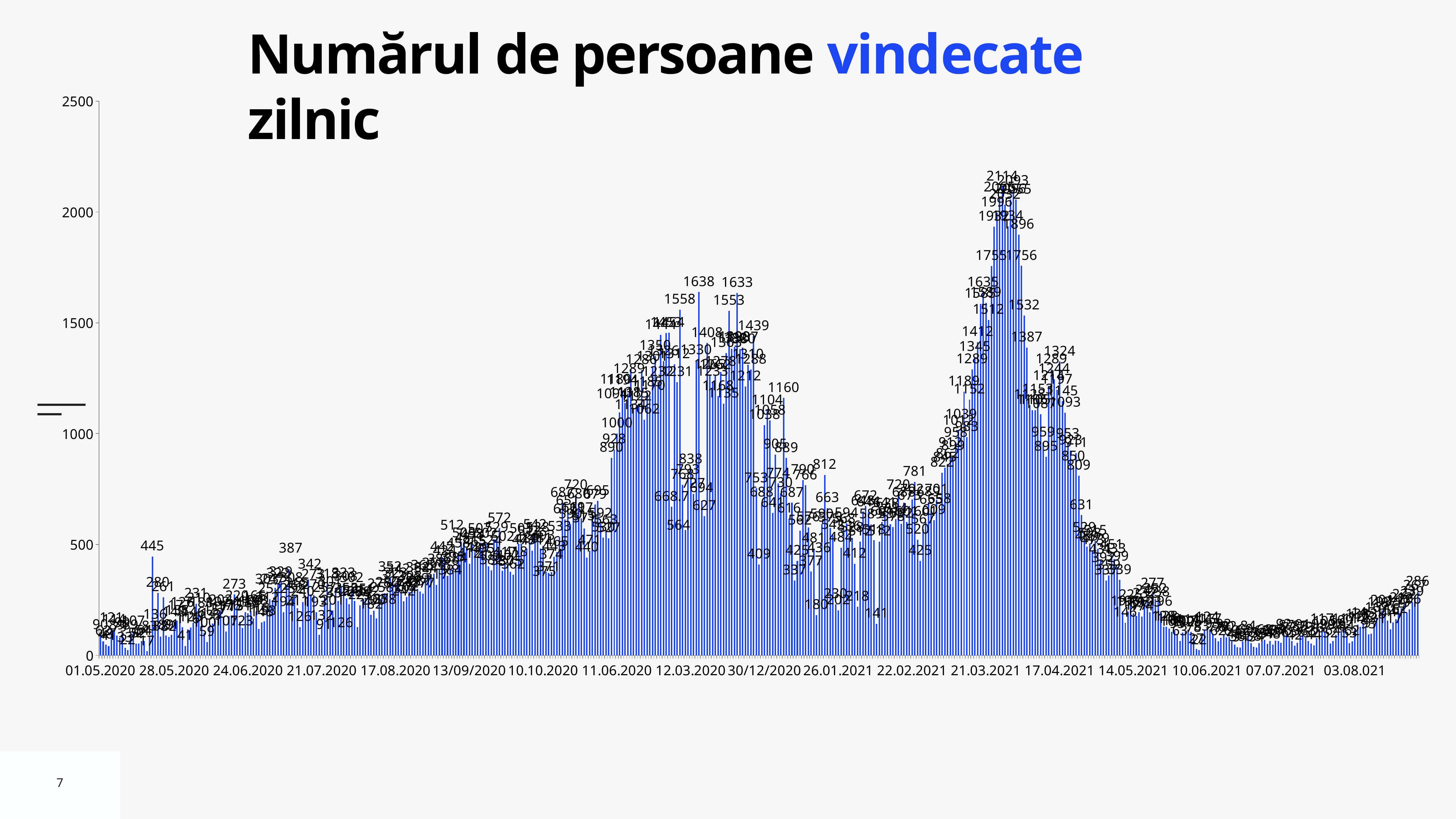
What is the difference between the bar labeled 2114 and the bar labeled 1638? 476 Are the bars at the far right end of the chart (after 03.08.2021) greater or less than 500? less Is the highest bar on the chart greater or less than 2000? greater Between the x-axis labels 21.03.2021 and 14.05.2021, do the values generally rise or fall? fall What kind of chart is shown on the slide? bar chart What is the title of the chart? Numărul de persoane vindecate zilnic Between the x-axis labels 22.02.2021 and 21.03.2021, do the values generally rise or fall? rise What is the last label shown on the x axis? 03.08.2021 Is the bar labeled 387 greater or less than 500? less Which is larger, the bar labeled 1756 or the bar labeled 1532? 1756 What is the highest value labeled on the chart? 2114 What is the value of the tallest bar in the first small peak near 28.05.2020? 445